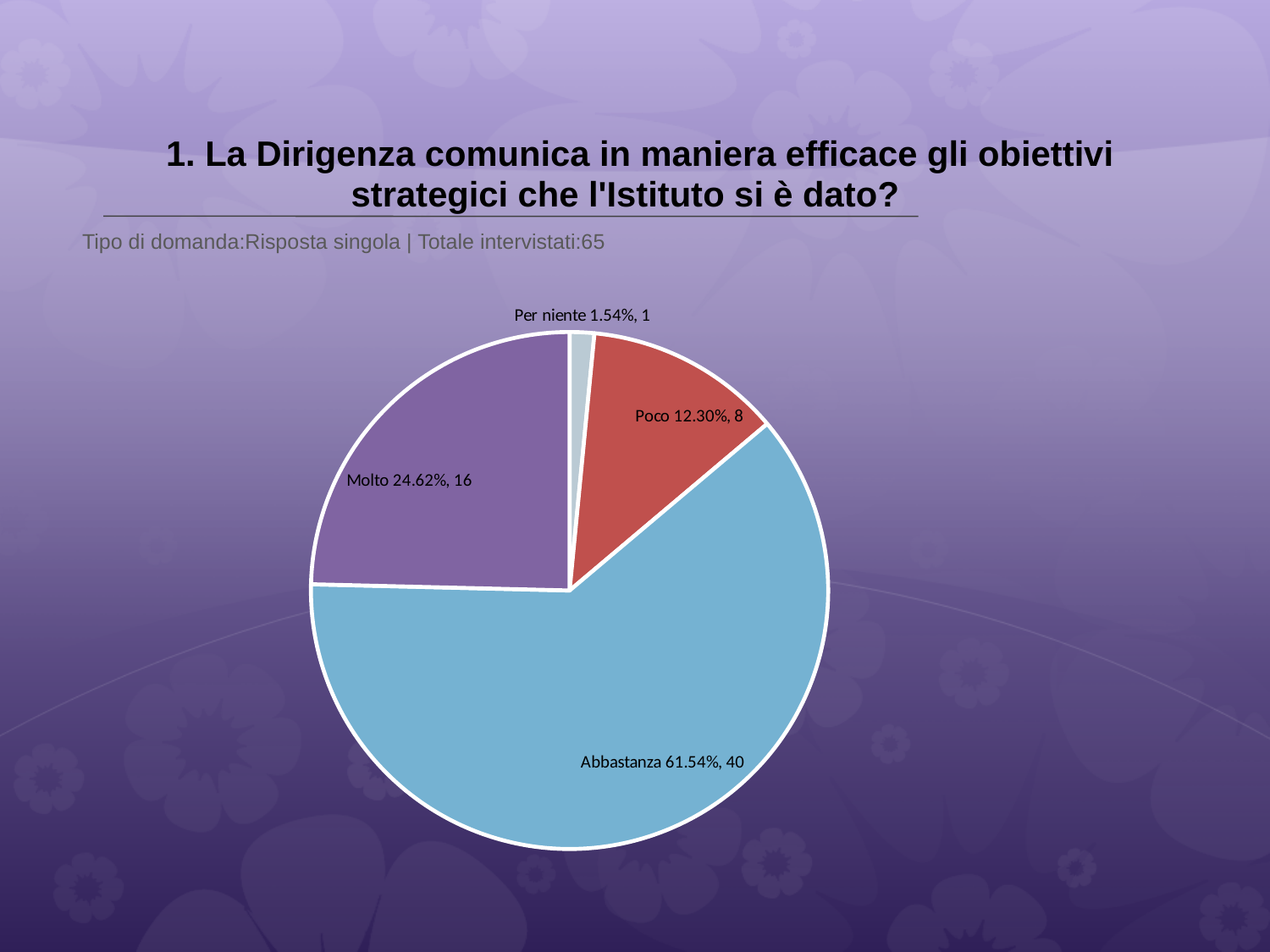
What is the difference in count between 'Abbastanza' and 'Molto'? 24 What percentage share does the 'Per niente' slice have? 1.54% What is the count for the 'Poco' slice? 8 What is the total number of respondents across all slices? 65 How many slices does the pie chart have? 4 Which category has the smallest slice? Per niente Which is larger, the count for 'Molto' or the count for 'Poco'? Molto What percentage share does the 'Molto' slice have? 24.62% Which category has the largest slice? Abbastanza What colour is the 'Abbastanza' slice? light blue What is the count for the 'Abbastanza' slice? 40 What kind of chart is shown on the slide? pie chart